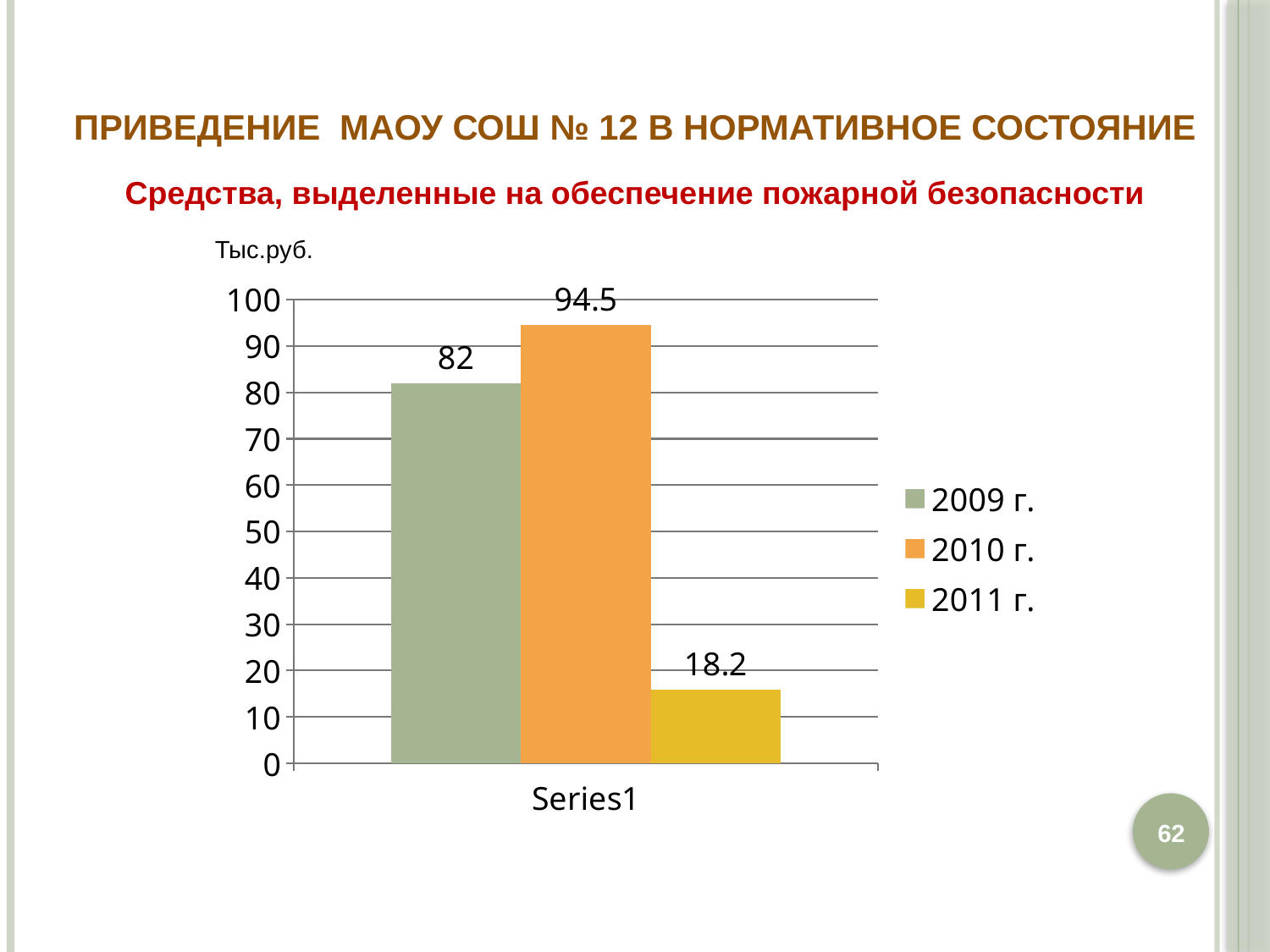
What kind of chart is shown on the slide? bar chart What value is shown for 2011 г.? 18.2 What is the difference between the values for 2009 г. and 2011 г.? 63.8 Is the value for 2011 г. greater or less than 20? less What is the difference between the values for 2010 г. and 2009 г.? 12.5 How many series does the legend list? 3 What value is shown for 2010 г.? 94.5 Which is larger, the value for 2009 г. or the value for 2011 г.? 2009 г. What unit label is shown above the vertical axis? Тыс.руб. Which year has the highest value? 2010 г. What value is shown for 2009 г.? 82 Which year has the lowest value? 2011 г.